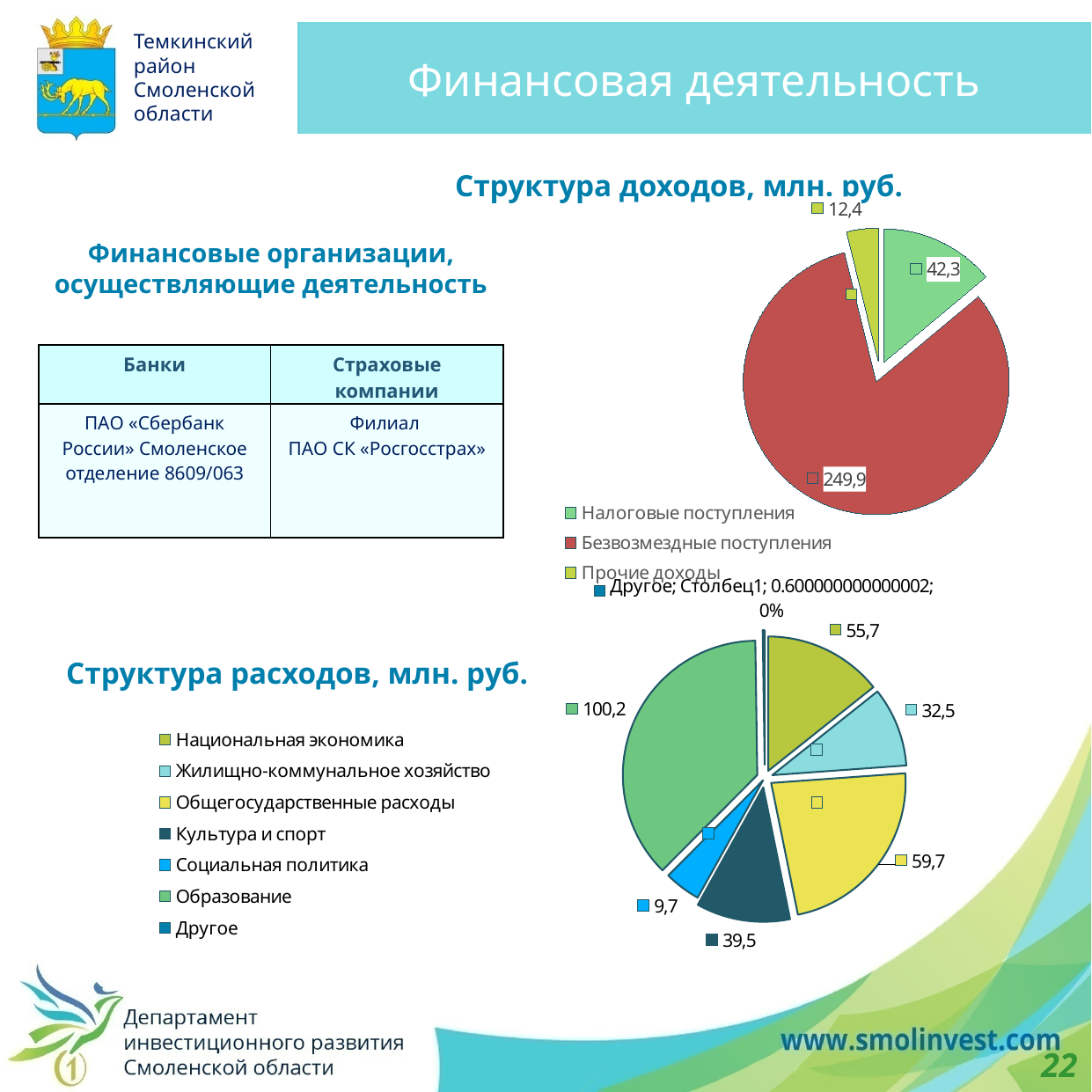
How many entries does the legend of the chart 'Структура доходов, млн. руб.' list? 3 In the chart 'Структура доходов, млн. руб.', which category has the largest value? Безвозмездные поступления In the chart 'Структура доходов, млн. руб.', what is the value for Безвозмездные поступления? 249,9 In the chart 'Структура расходов, млн. руб.', what is the value for Образование? 100,2 How many entries does the legend of the chart 'Структура расходов, млн. руб.' list? 7 In the chart 'Структура расходов, млн. руб.', what is the value for Социальная политика? 9,7 In the chart 'Структура доходов, млн. руб.', what is the difference between Безвозмездные поступления and Налоговые поступления? 207,6 In the chart 'Структура расходов, млн. руб.', what is the difference between Образование and Культура и спорт? 60,7 What kind of chart is 'Структура расходов, млн. руб.'? Pie chart In the chart 'Структура доходов, млн. руб.', what is the value for Налоговые поступления? 42,3 In the chart 'Структура доходов, млн. руб.', which category has the smallest value? Прочие доходы In the chart 'Структура расходов, млн. руб.', which is larger: Общегосударственные расходы or Национальная экономика? Общегосударственные расходы